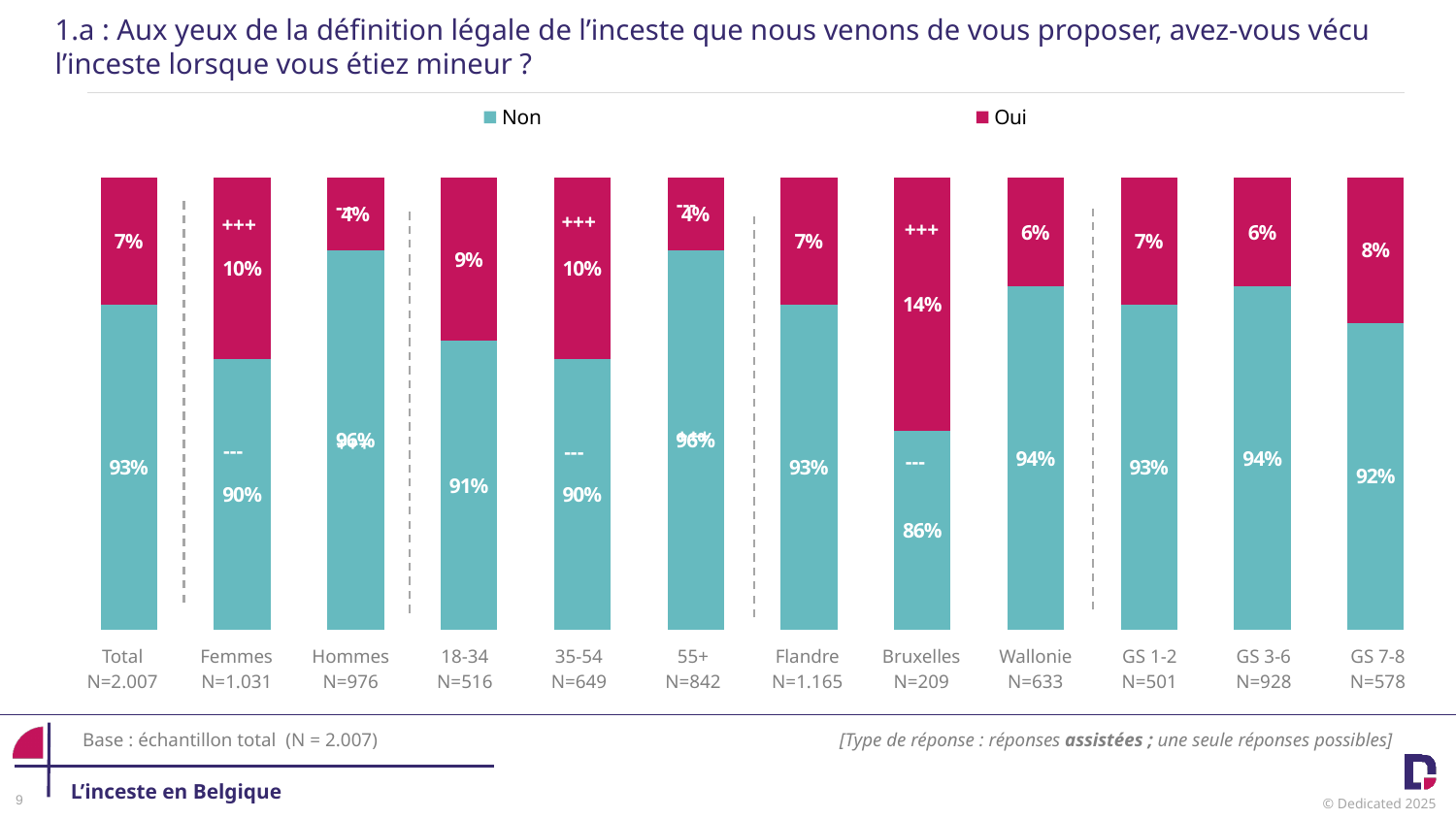
Which has a larger "Oui" value, Femmes or Wallonie? Femmes What percentage of respondents in Bruxelles answered "Oui"? 14% What kind of chart is shown on the slide? Stacked bar chart How many categories (bars) are shown on the chart? 12 What is the total of the stacked bar for Total (Non plus Oui)? 100% Which category has the highest "Oui" percentage? Bruxelles What is the "Non" value for the 18-34 age group? 91% How many series does the legend list? 2 Which category has the lowest "Non" percentage? Bruxelles What is the "Oui" value for GS 7-8? 8% What is the "Non" value for Femmes? 90% How many percentage points higher is the "Oui" value for Bruxelles than for Total? 7 percentage points